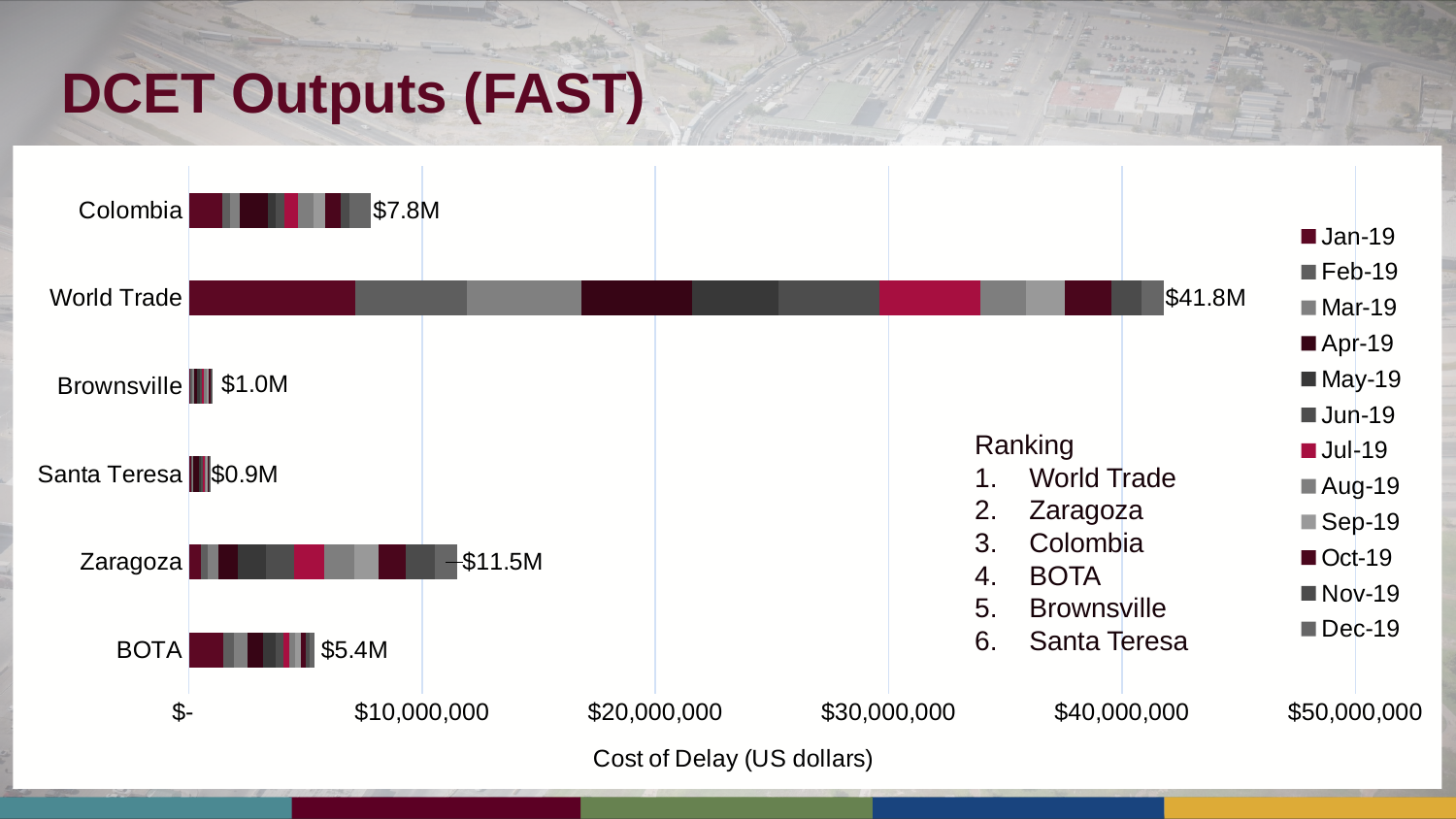
Is the total cost of delay for World Trade greater or less than $40,000,000? greater What is the total cost of delay shown for World Trade? $41.8M How many ports are shown on the chart? 6 What is the total cost of delay shown for Zaragoza? $11.5M How many series does the legend list? 12 Which port has the highest total cost of delay? World Trade Which port has the lowest total cost of delay? Santa Teresa What kind of chart is shown on the slide? Stacked bar chart What is the total cost of delay shown for BOTA? $5.4M Which has a larger total cost of delay, Brownsville or BOTA? BOTA What is the difference between the total cost of delay for Zaragoza and Colombia? $3.7M What is the total cost of delay shown for Colombia? $7.8M